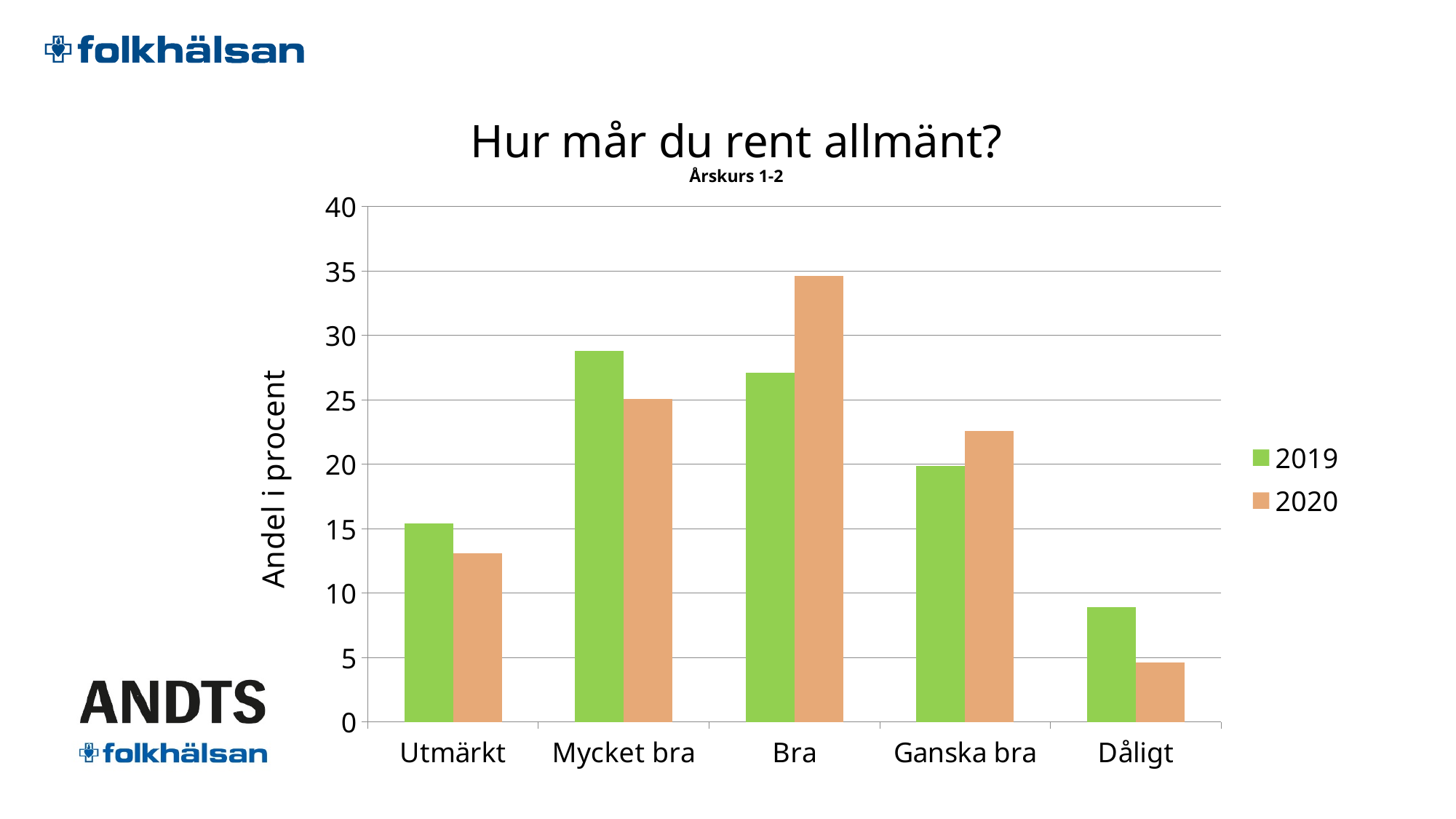
How many series does the legend list? 2 For Utmärkt, which series has the larger value, 2019 or 2020? 2019 Which category has the highest value for 2020? Bra Is the value for Bra in 2020 greater or less than 30? greater How many categories are shown on the x axis? 5 Which category has the lowest value for 2019? Dåligt What is the label of the y axis? Andel i procent For Bra, which series has the larger value, 2019 or 2020? 2020 Is the value for Utmärkt in 2020 greater or less than 15? less Which category has the lowest value for 2020? Dåligt What kind of chart is shown on the slide? bar chart